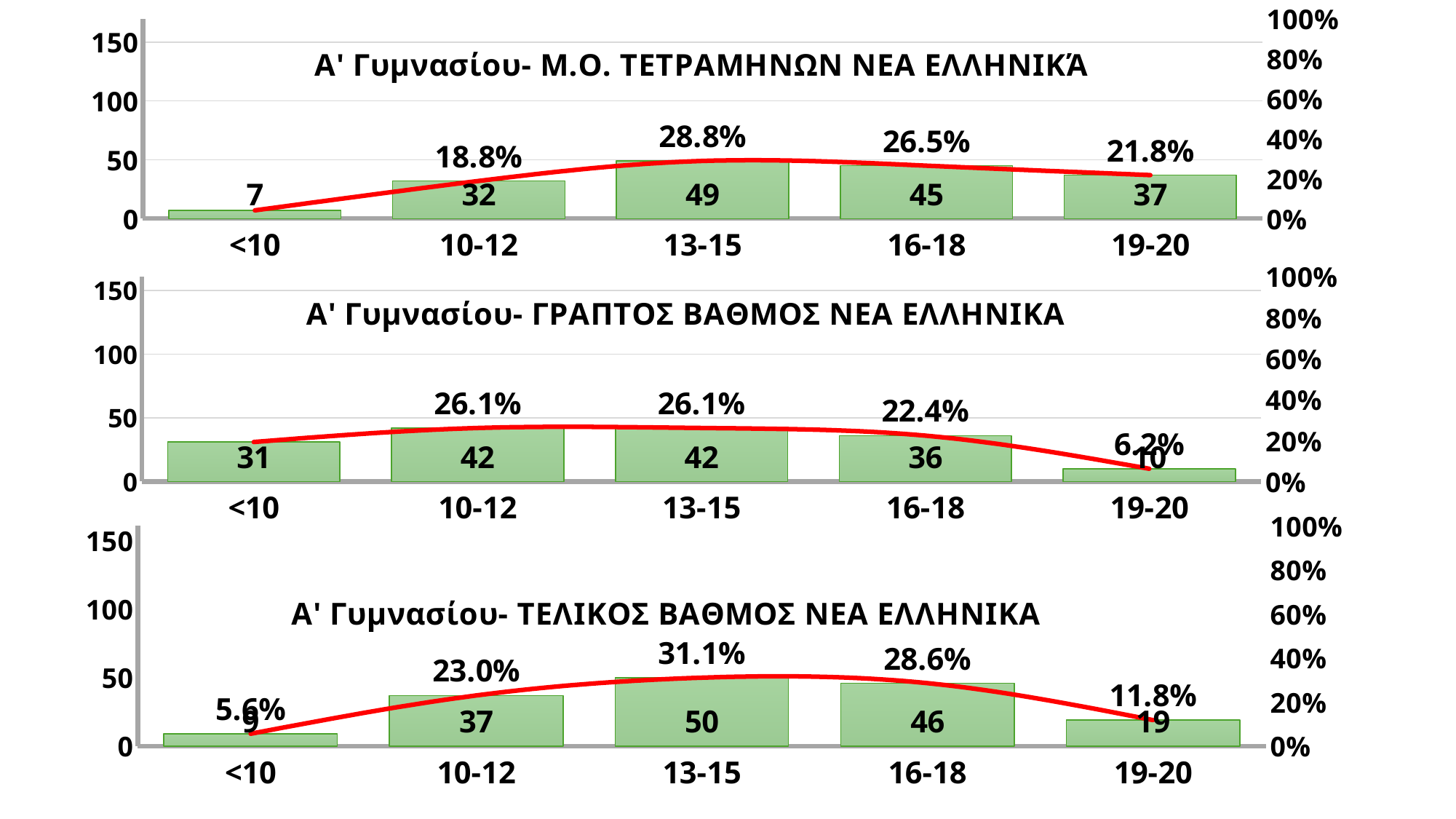
In the middle chart (ΓΡΑΠΤΟΣ ΒΑΘΜΟΣ), what is the bar value for the 19-20 category? 10 In the middle chart (ΓΡΑΠΤΟΣ ΒΑΘΜΟΣ), which is larger, the bar value for <10 or for 16-18? 16-18 In the top chart (Μ.Ο. ΤΕΤΡΑΜΗΝΩΝ), what percentage is shown for the 16-18 category? 26.5% In the bottom chart (ΤΕΛΙΚΟΣ ΒΑΘΜΟΣ), what is the difference between the bar values for 16-18 and 19-20? 27 In the middle chart (ΓΡΑΠΤΟΣ ΒΑΘΜΟΣ), what percentage is shown for the 16-18 category? 22.4% What type of chart is used for the counts in the top chart (Μ.Ο. ΤΕΤΡΑΜΗΝΩΝ)? Bar chart In the top chart (Μ.Ο. ΤΕΤΡΑΜΗΝΩΝ), what is the bar value for the 13-15 category? 49 How many categories are shown on the x axis of the bottom chart (ΤΕΛΙΚΟΣ ΒΑΘΜΟΣ)? 5 In the top chart (Μ.Ο. ΤΕΤΡΑΜΗΝΩΝ), which category has the lowest bar value? <10 In the bottom chart (ΤΕΛΙΚΟΣ ΒΑΘΜΟΣ), what percentage is shown for the <10 category? 5.6% In the bottom chart (ΤΕΛΙΚΟΣ ΒΑΘΜΟΣ), which category has the highest bar value? 13-15 In the top chart (Μ.Ο. ΤΕΤΡΑΜΗΝΩΝ), what is the difference between the bar values for 13-15 and 19-20? 12